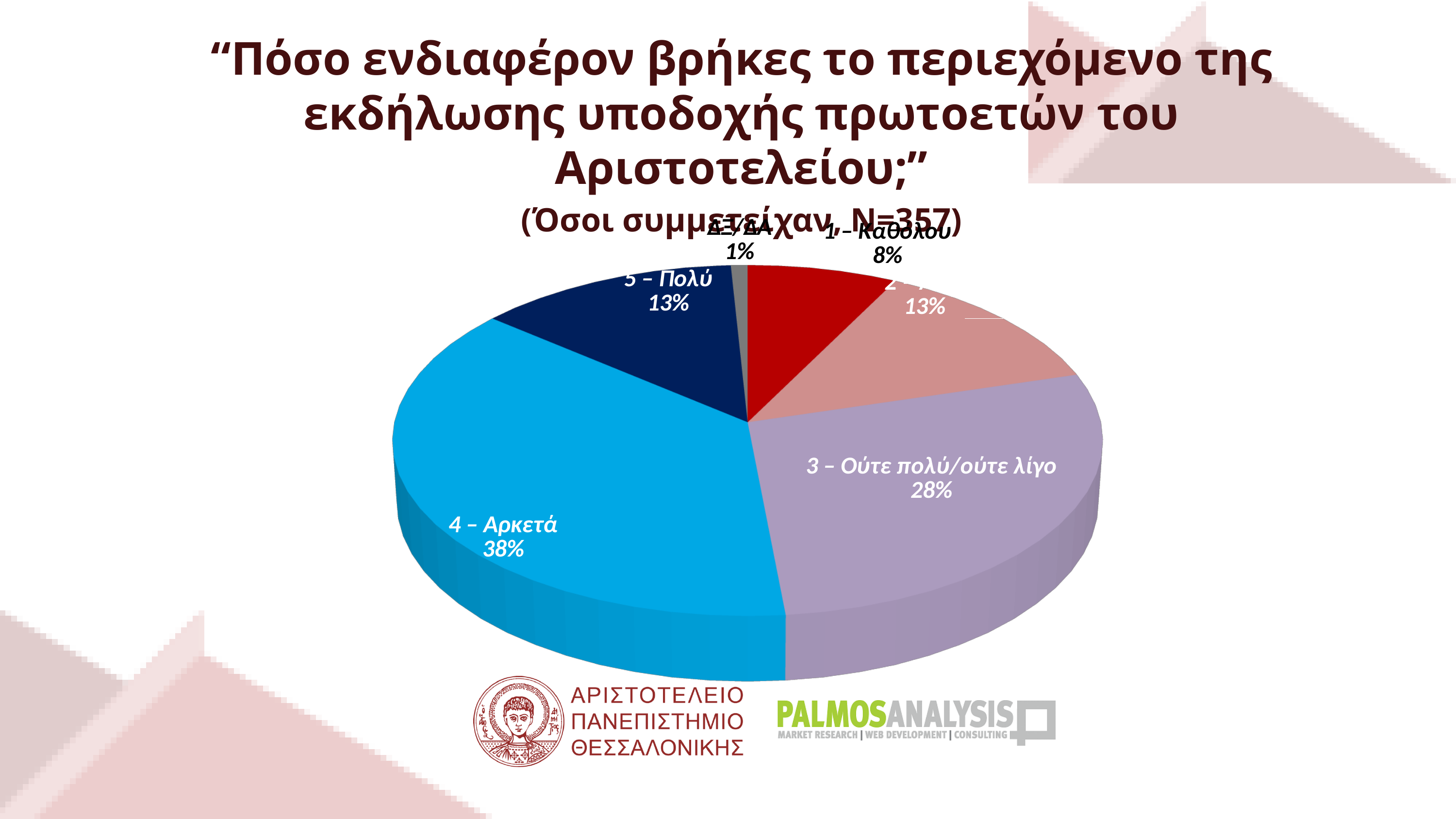
What percentage of respondents answered "3 – Ούτε πολύ/ούτε λίγο"? 28% Which response category has the largest share of the pie? 4 – Αρκετά How many slices does the pie chart have? 6 How many percentage points larger is the share for "4 – Αρκετά" than for "3 – Ούτε πολύ/ούτε λίγο"? 10 percentage points What percentage of respondents answered "1 – Καθόλου"? 8% What percentage of respondents answered "5 – Πολύ"? 13% What percentage of respondents answered "4 – Αρκετά"? 38% Which has the larger share: "3 – Ούτε πολύ/ούτε λίγο" or "5 – Πολύ"? 3 – Ούτε πολύ/ούτε λίγο What percentage of respondents answered "ΔΞ/ΔΑ"? 1% Which response category has the smallest share of the pie? ΔΞ/ΔΑ What is the sample size (N) stated in the chart subtitle? N=357 What kind of chart is shown on the slide? pie chart